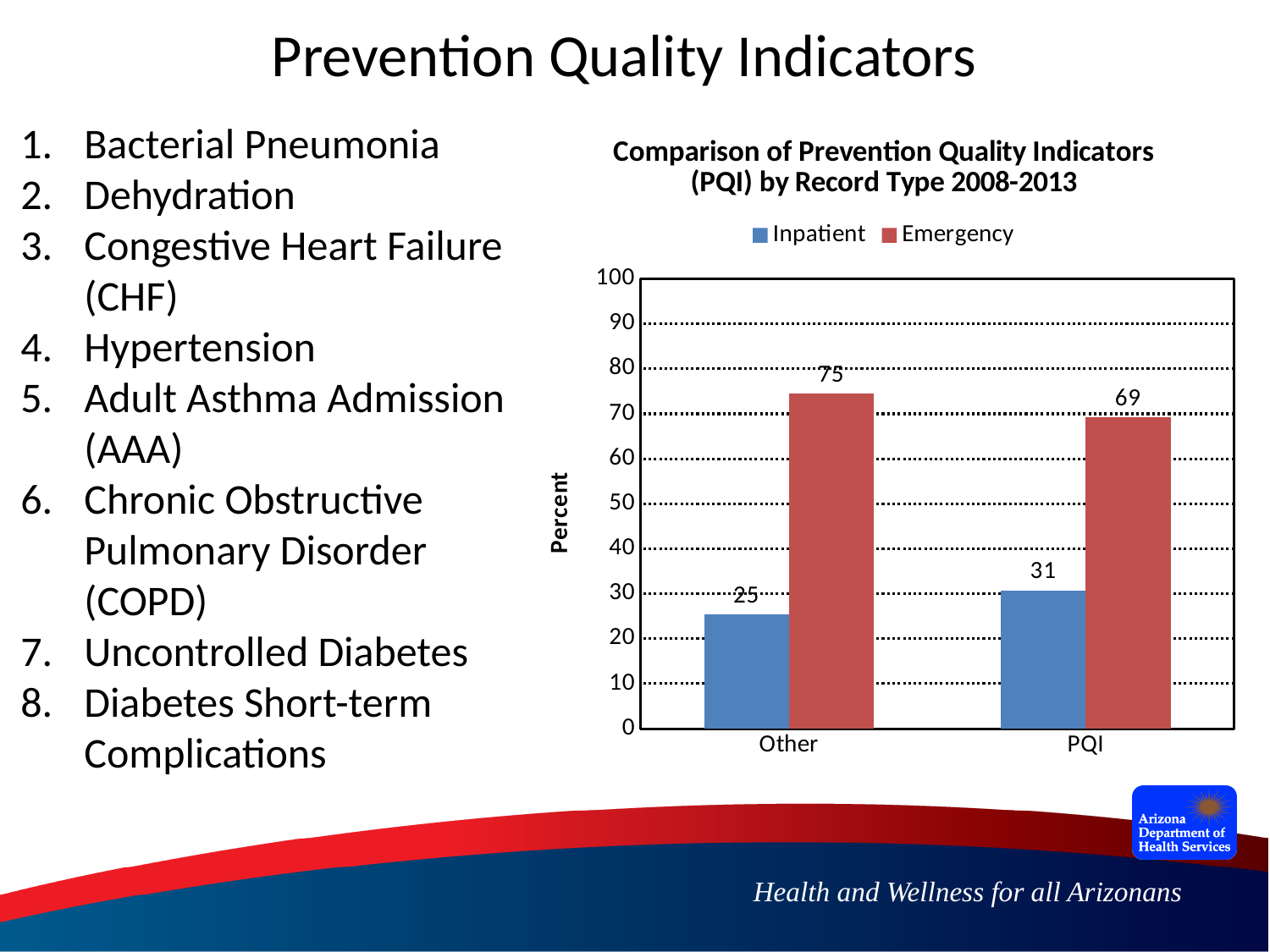
How many categories are shown on the x axis? 2 Which category has the highest Emergency value? Other How many series does the legend list? 2 What is the Inpatient value for PQI? 31 What is the difference between the Emergency and Inpatient values for PQI? 38 What kind of chart is shown? Bar chart What is the Emergency value for PQI? 69 What is the title of the chart? Comparison of Prevention Quality Indicators (PQI) by Record Type 2008-2013 Which category has the lowest Inpatient value? Other What is the Emergency value for Other? 75 Which is larger for Other: the Inpatient value or the Emergency value? Emergency What is the Inpatient value for Other? 25